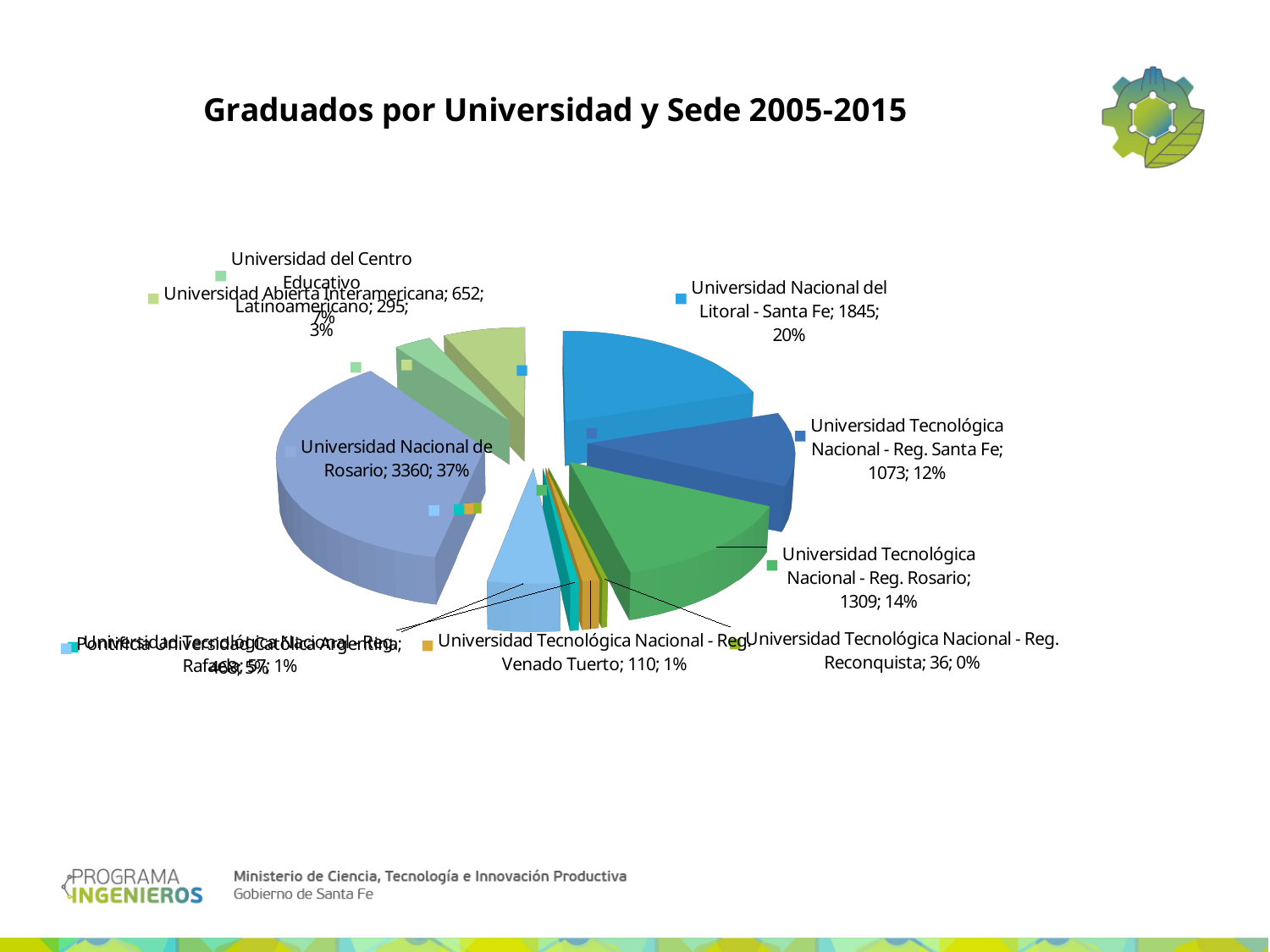
How many graduates are shown for Universidad Tecnológica Nacional - Reg. Venado Tuerto? 110 How many graduates are shown for Universidad Nacional del Litoral - Santa Fe? 1845 Which university has the smallest slice of the pie? Universidad Tecnológica Nacional - Reg. Reconquista How many graduates are shown for Universidad Abierta Interamericana? 652 How many graduates are shown for Universidad Tecnológica Nacional - Reg. Rosario? 1309 Which has more graduates, Universidad Tecnológica Nacional - Reg. Rosario or Universidad Tecnológica Nacional - Reg. Santa Fe? Universidad Tecnológica Nacional - Reg. Rosario What share of the pie does Universidad Tecnológica Nacional - Reg. Santa Fe represent? 12% What kind of chart is shown on the slide? pie chart What is the title of the chart? Graduados por Universidad y Sede 2005-2015 What is the difference in graduates between Universidad Nacional del Litoral - Santa Fe and Universidad Tecnológica Nacional - Reg. Santa Fe? 772 What share of the pie does Universidad Nacional de Rosario represent? 37% Which university has the largest slice of the pie? Universidad Nacional de Rosario